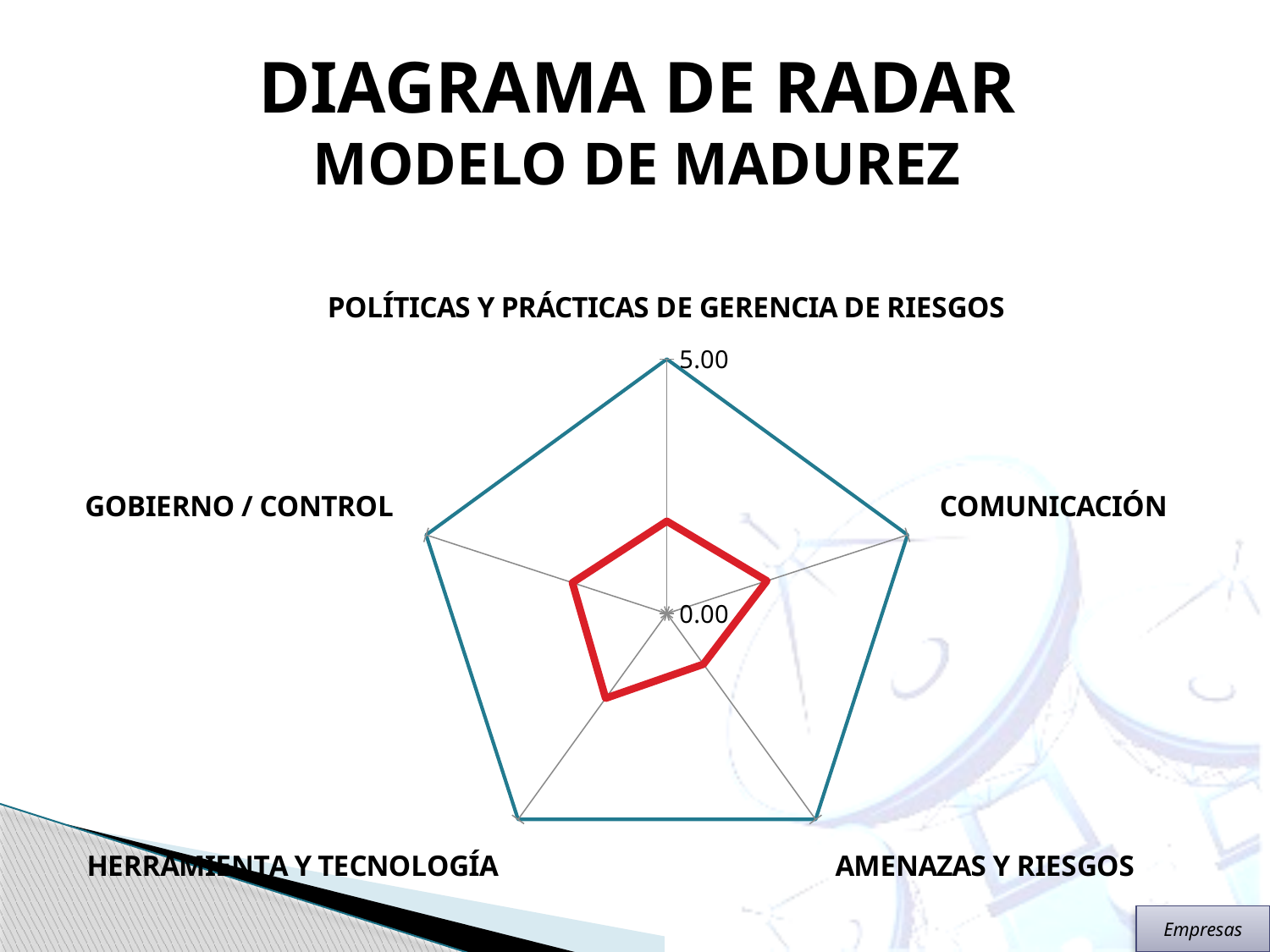
What is the maximum value shown on the radar chart's axis? 5.00 Is the value for POLÍTICAS Y PRÁCTICAS DE GERENCIA DE RIESGOS greater or less than 5.00? less What kind of chart is shown on the slide? radar chart How many categories (axes) does the radar chart have? 5 Which is larger on the radar chart, the value for COMUNICACIÓN or the value for AMENAZAS Y RIESGOS? COMUNICACIÓN Which category has the lowest value on the radar chart? AMENAZAS Y RIESGOS How many data series are plotted on the radar chart? 1 What is the value label shown at the centre of the radar chart? 0.00 Which is larger on the radar chart, the value for GOBIERNO / CONTROL or the value for AMENAZAS Y RIESGOS? GOBIERNO / CONTROL Is the value for HERRAMIENTA Y TECNOLOGÍA greater or less than 5.00? less Which category label appears at the top of the radar chart? POLÍTICAS Y PRÁCTICAS DE GERENCIA DE RIESGOS